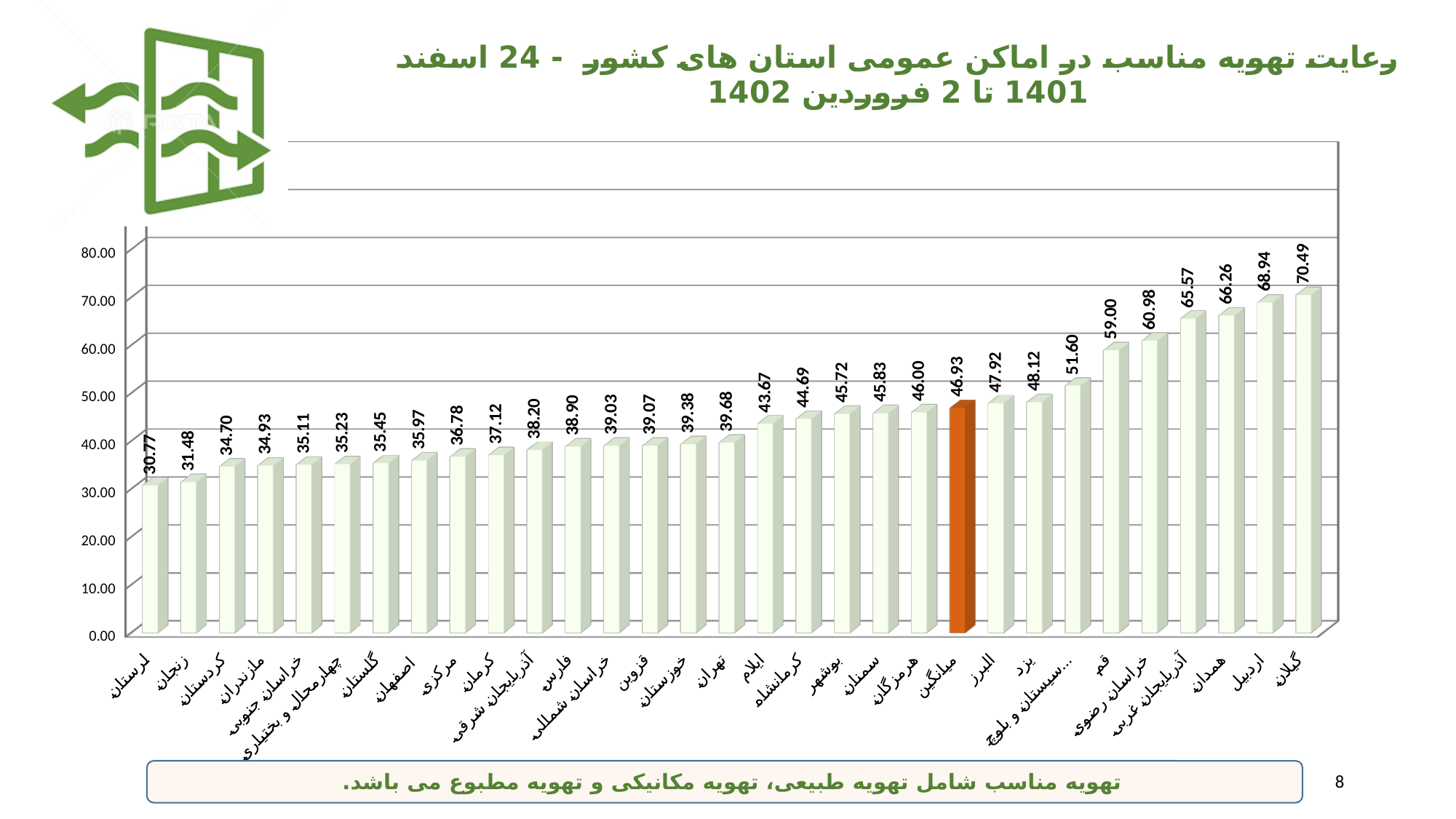
What colour is the bar for میانگین, which differs from the other bars? orange Which category has the lowest value? لرستان What is the value for تهران? 39.68 Do the values rise or fall from left to right along the x axis? rise Which is larger, the value for قم or the value for یزد? قم What is the value of the highlighted orange bar labelled میانگین? 46.93 What kind of chart is shown on the slide? bar chart Which category has the highest value? گیلان What is the difference between the values for گیلان and لرستان? 39.72 How many bars are plotted in the chart? 31 Is the value for اردبیل greater or less than 60.00? greater What is the value for گیلان? 70.49